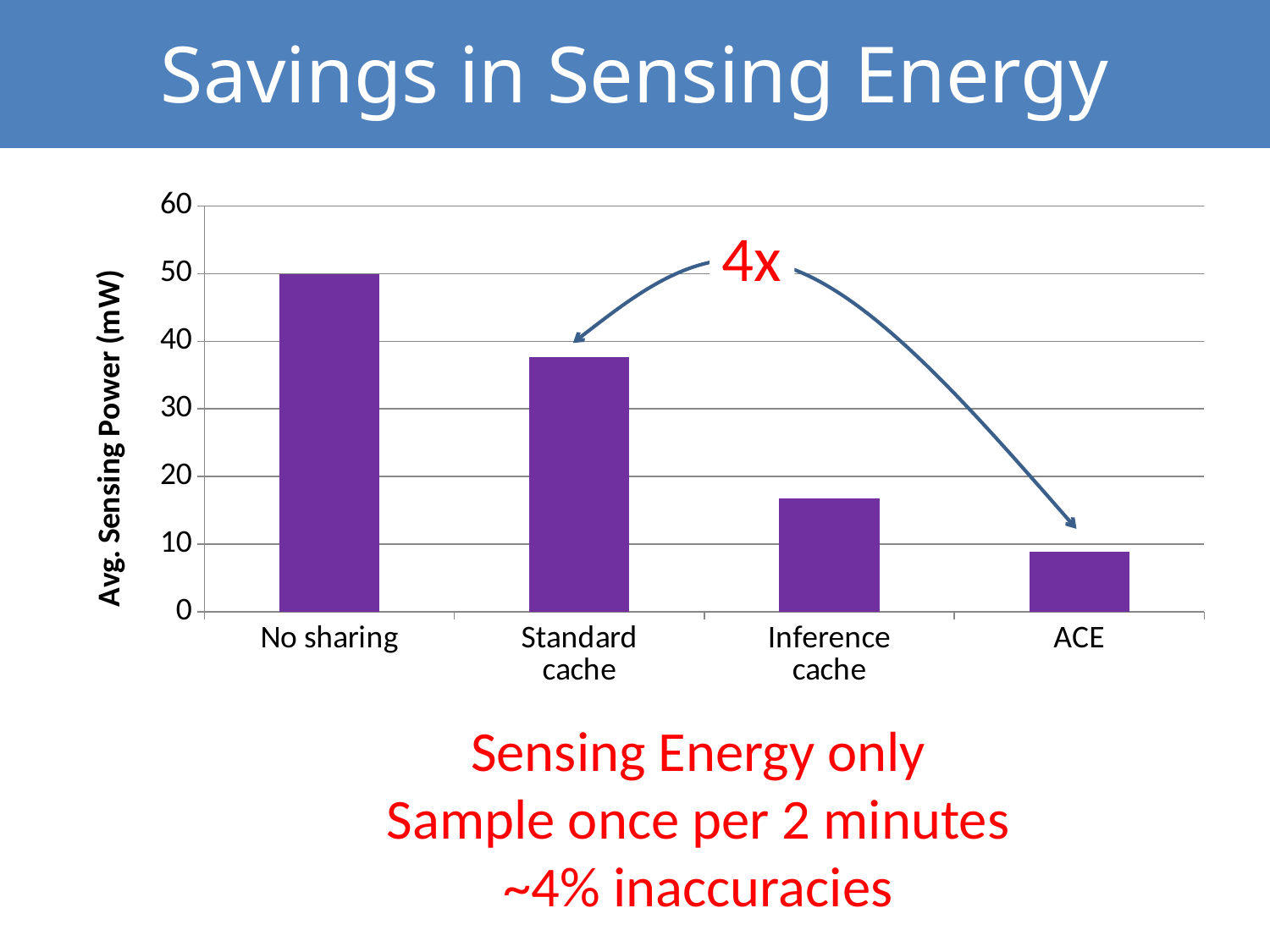
What kind of chart is shown on the slide? bar chart How many categories are plotted on the x axis? 4 Is the value for ACE greater or less than 10? less Is the value for Inference cache greater or less than 20? less Which category has the highest average sensing power? No sharing Do the bar values rise or fall from left to right along the x axis? fall Which category has the lowest average sensing power? ACE Is the value for Standard cache greater or less than 30? greater Which has a higher average sensing power, Standard cache or Inference cache? Standard cache What is the label on the y axis of the chart? Avg. Sensing Power (mW)